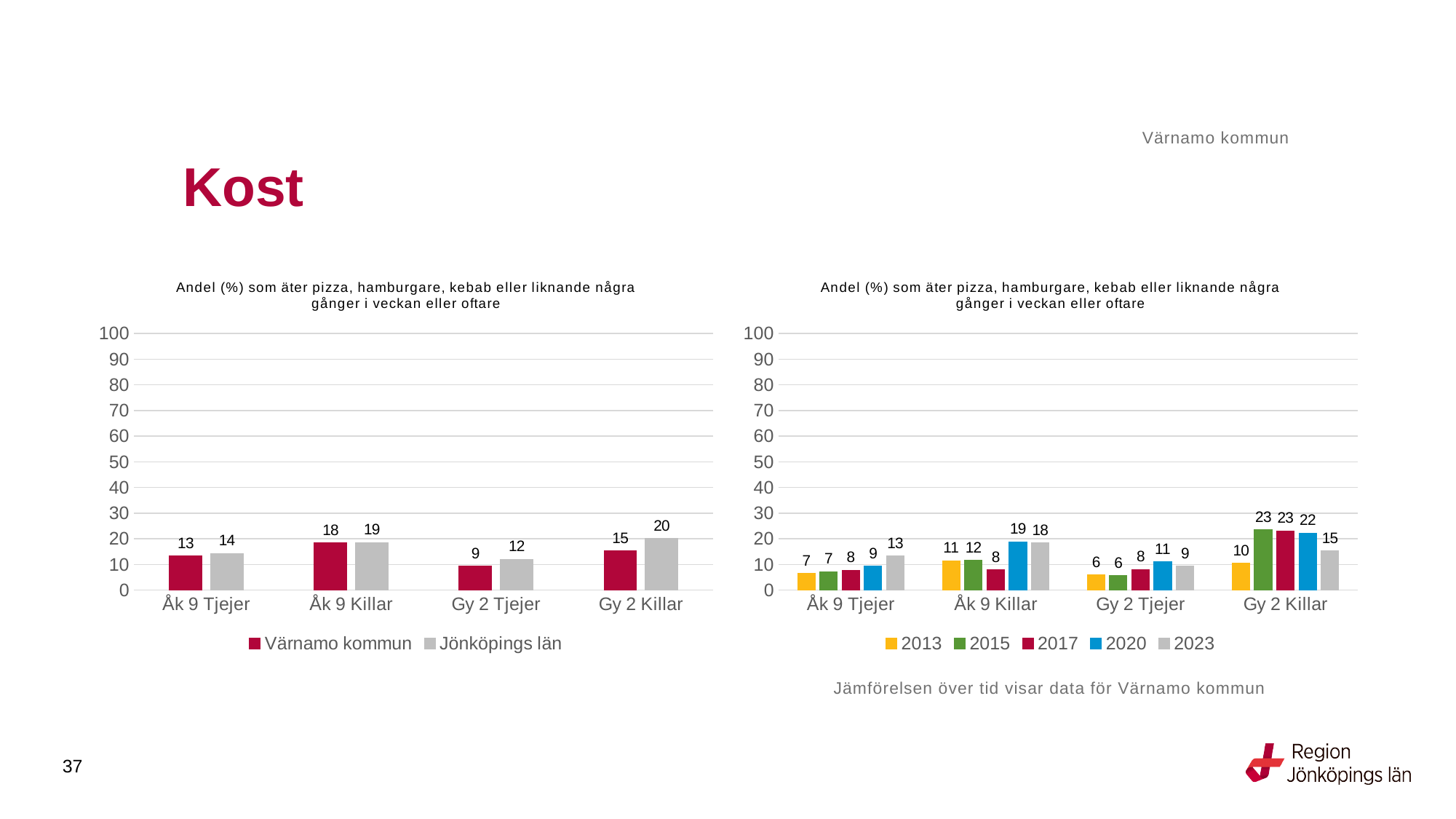
In the right chart, is the value for 2013 for Gy 2 Tjejer larger or smaller than the value for 2020 for Gy 2 Tjejer? smaller In the right chart, which year has the highest value for Åk 9 Tjejer? 2023 In the right chart, what is the value for 2020 for Åk 9 Killar? 19 In the right chart, how many series does the legend list? 5 In the left chart, how many series does the legend list? 2 In the right chart, what is the value for 2023 for Gy 2 Killar? 15 In the left chart, what is the value for Värnamo kommun for Åk 9 Killar? 18 What kind of chart is the right chart? Bar chart In the right chart, how many categories are shown on the x axis? 4 In the left chart, what is the difference between Jönköpings län and Värnamo kommun for Gy 2 Killar? 5 In the left chart, which category has the lowest value for Värnamo kommun? Gy 2 Tjejer In the left chart, what is the value for Jönköpings län for Gy 2 Killar? 20